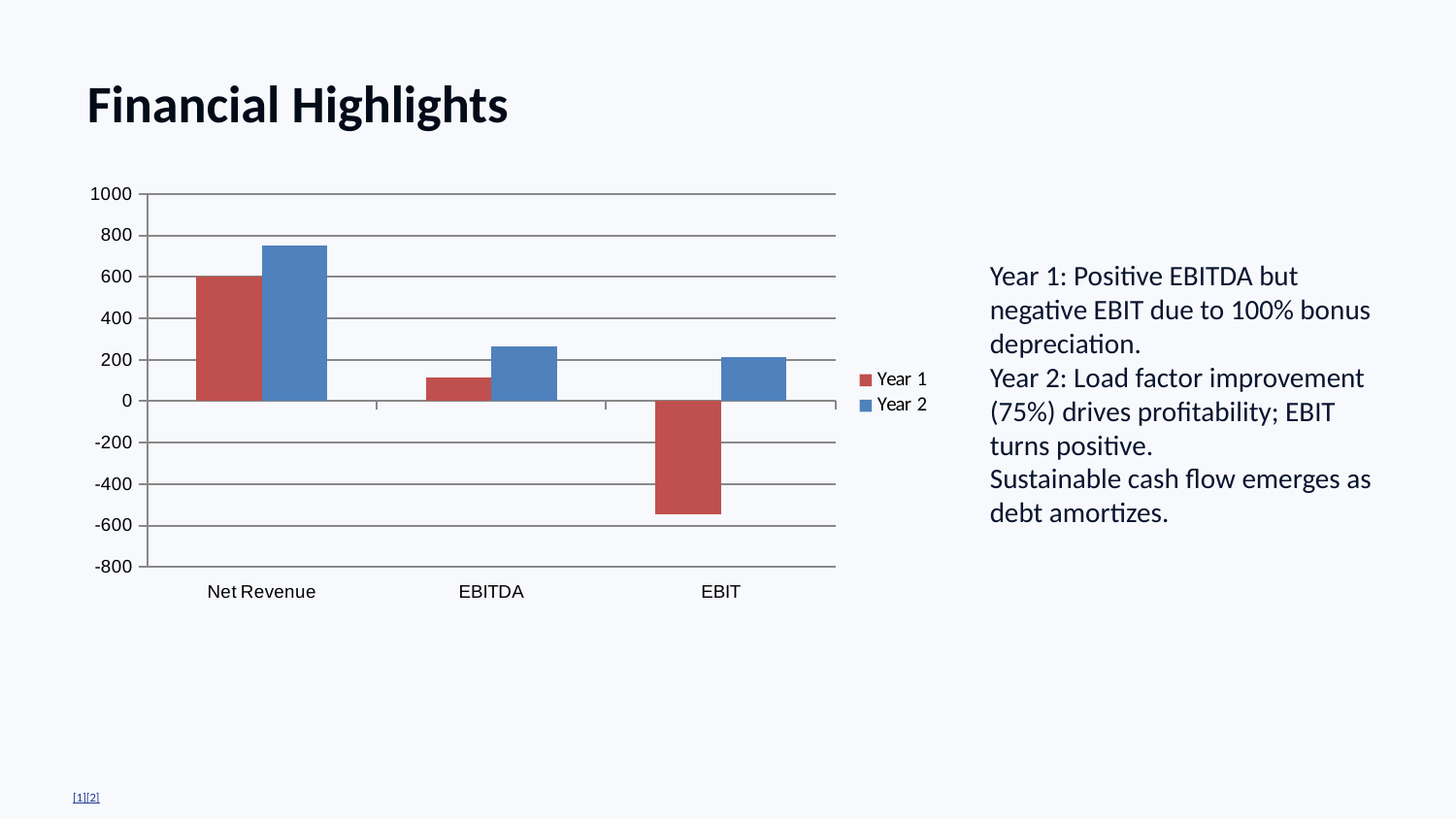
For Net Revenue, which series has the larger value, Year 1 or Year 2? Year 2 Which category and series has the lowest bar in the chart? EBIT, Year 1 Is the Year 1 value for EBIT greater or less than -400? less What colour are the Year 1 bars in the chart? red What kind of chart is shown on the slide? bar chart How many categories are shown on the x axis of the chart? 3 Which category and series has the highest bar in the chart? Net Revenue, Year 2 What are the series names listed in the chart's legend? Year 1, Year 2 How many series does the chart's legend list? 2 Is the Year 2 value for EBIT greater or less than 0? greater Is the Year 2 value for Net Revenue greater or less than 600? greater